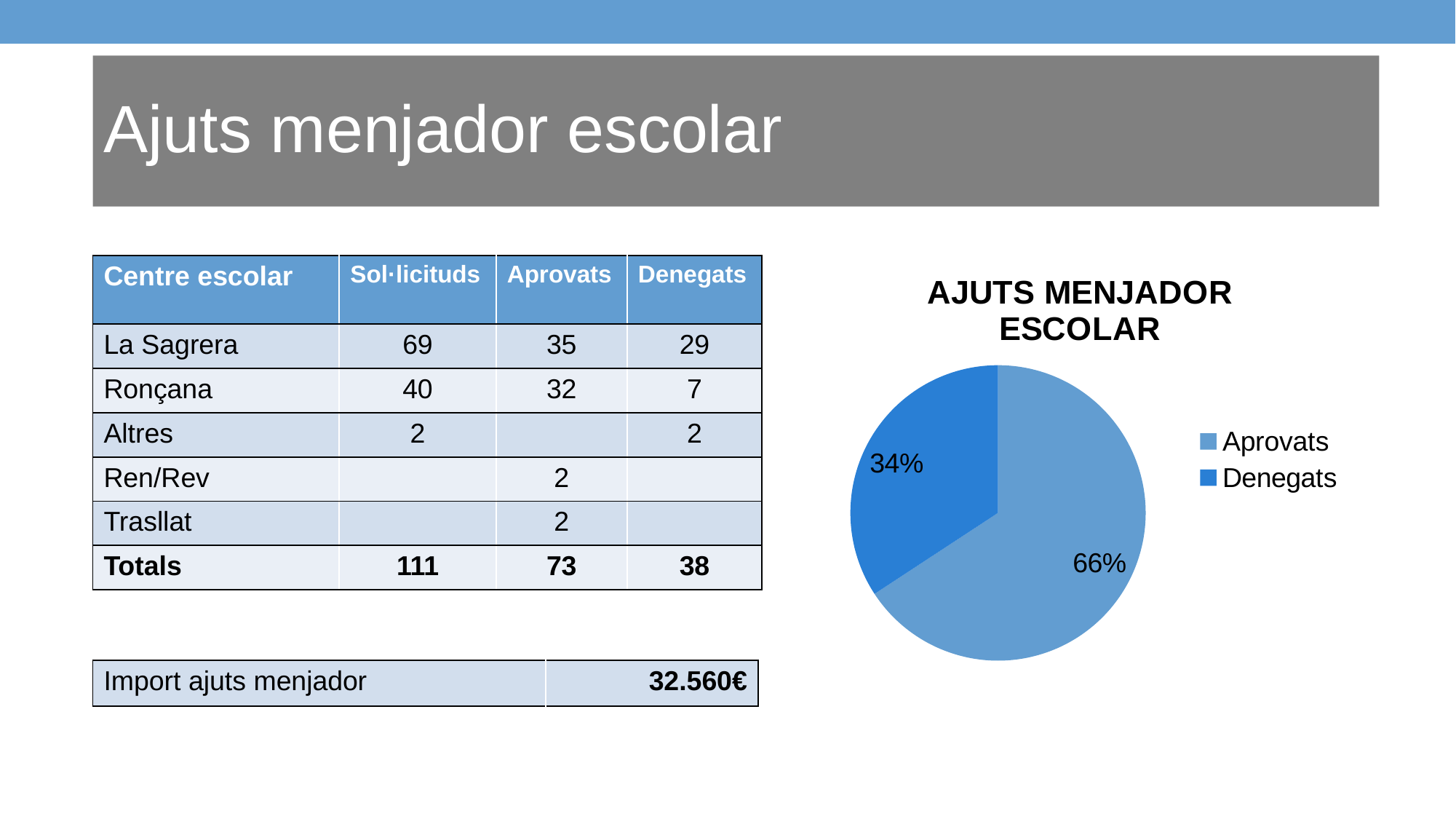
Which legend entry is shown in the darker blue colour? Denegats What share of the pie does Aprovats represent? 66% How many slices does the pie chart have? 2 What is the title of the chart? AJUTS MENJADOR ESCOLAR Which is larger, the Aprovats slice or the Denegats slice? Aprovats How many entries does the legend list? 2 Which slice of the pie is the largest? Aprovats What kind of chart is shown on the slide? pie chart Which slice of the pie is the smallest? Denegats Is the Aprovats share greater or less than 50%? greater What is the difference in percentage points between the Aprovats and Denegats slices? 32 percentage points What share of the pie does Denegats represent? 34%